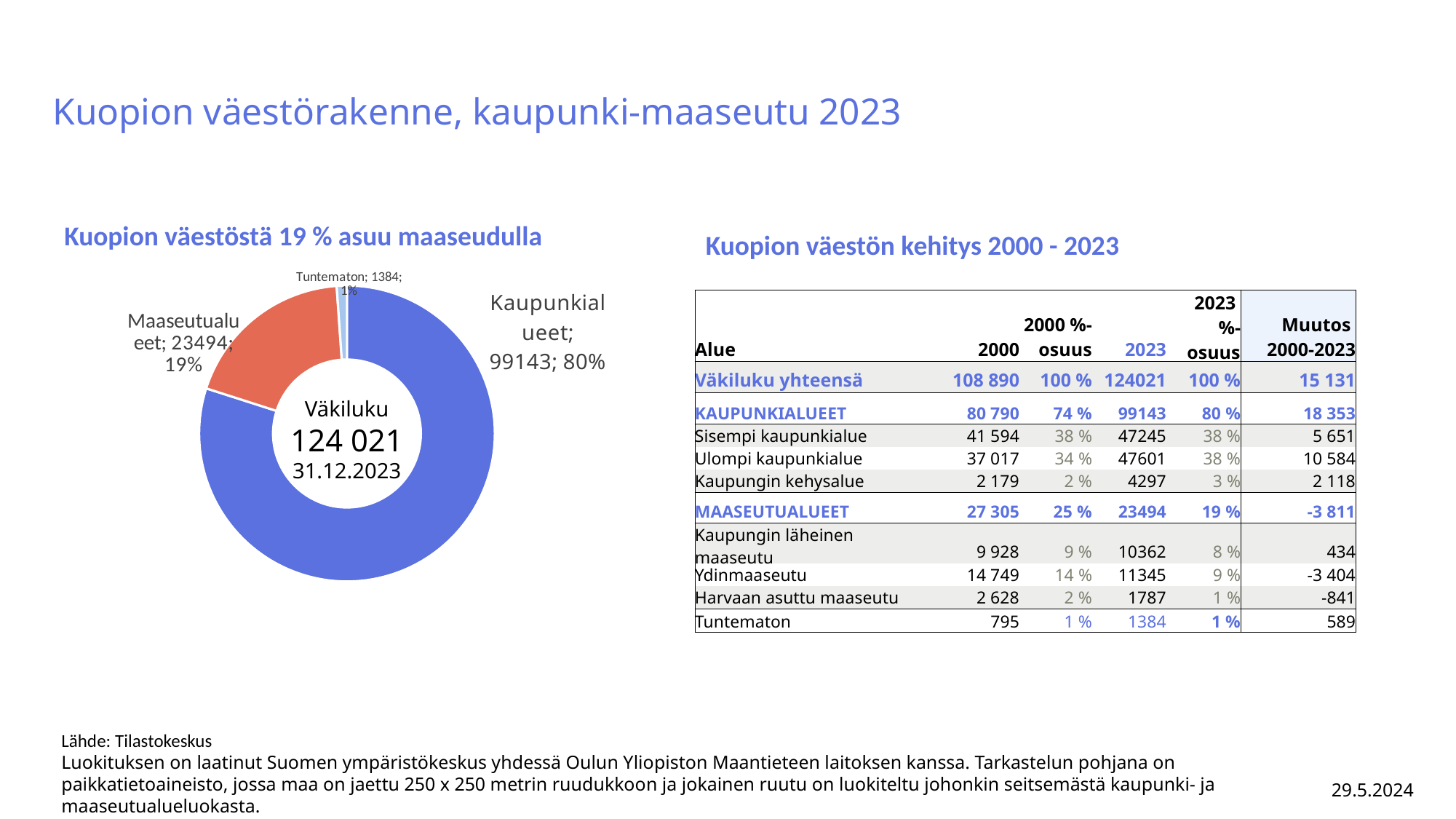
What share of the donut chart does Maaseutualueet represent? 19% What share of the donut chart does Kaupunkialueet represent? 80% What is the difference between the values for Kaupunkialueet and Maaseutualueet in the donut chart? 75649 What is the value shown for Kaupunkialueet in the donut chart? 99143 How many slices does the donut chart have? 3 What kind of chart is shown on the left of the slide? Donut (pie) chart What is the value shown for Tuntematon in the donut chart? 1384 What total population figure is shown in the centre of the donut chart? 124 021 Which is larger in the donut chart, Maaseutualueet or Tuntematon? Maaseutualueet What is the value shown for Maaseutualueet in the donut chart? 23494 Which category has the smallest slice in the donut chart? Tuntematon Which category has the largest slice in the donut chart? Kaupunkialueet